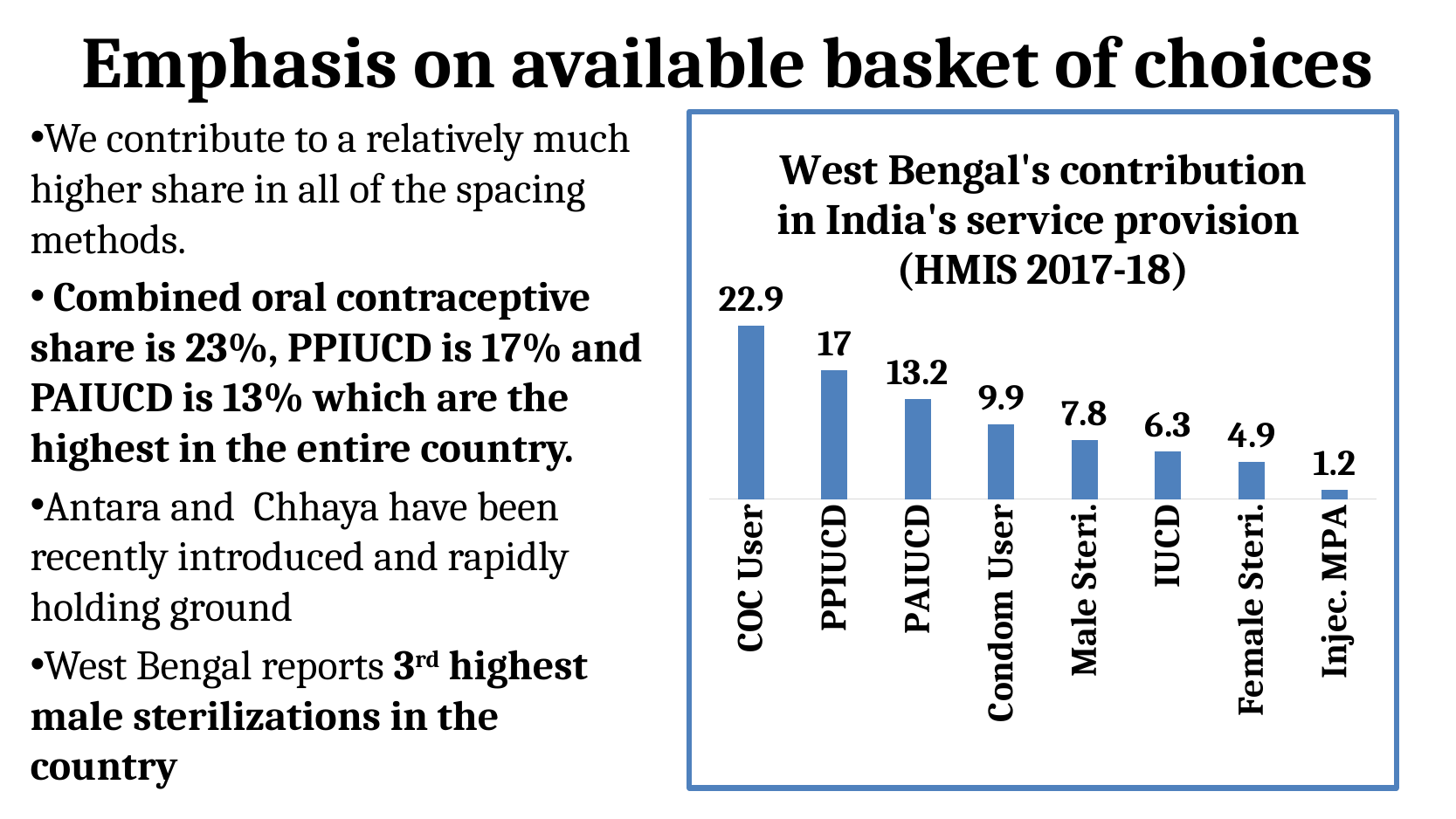
What is the value for COC User? 22.9 What is the title of the chart? West Bengal's contribution in India's service provision (HMIS 2017-18) What kind of chart is shown on the slide? Bar chart Which is larger, the value for Male Steri. or the value for Female Steri.? Male Steri. What is the value for Female Steri.? 4.9 Do the values rise or fall from left to right along the x axis? Fall Which category has the lowest value? Injec. MPA What is the difference between the values for PPIUCD and PAIUCD? 3.8 What is the difference between the values for Male Steri. and IUCD? 1.5 How many categories are shown in the chart? 8 Which category has the highest value? COC User What is the value for Condom User? 9.9